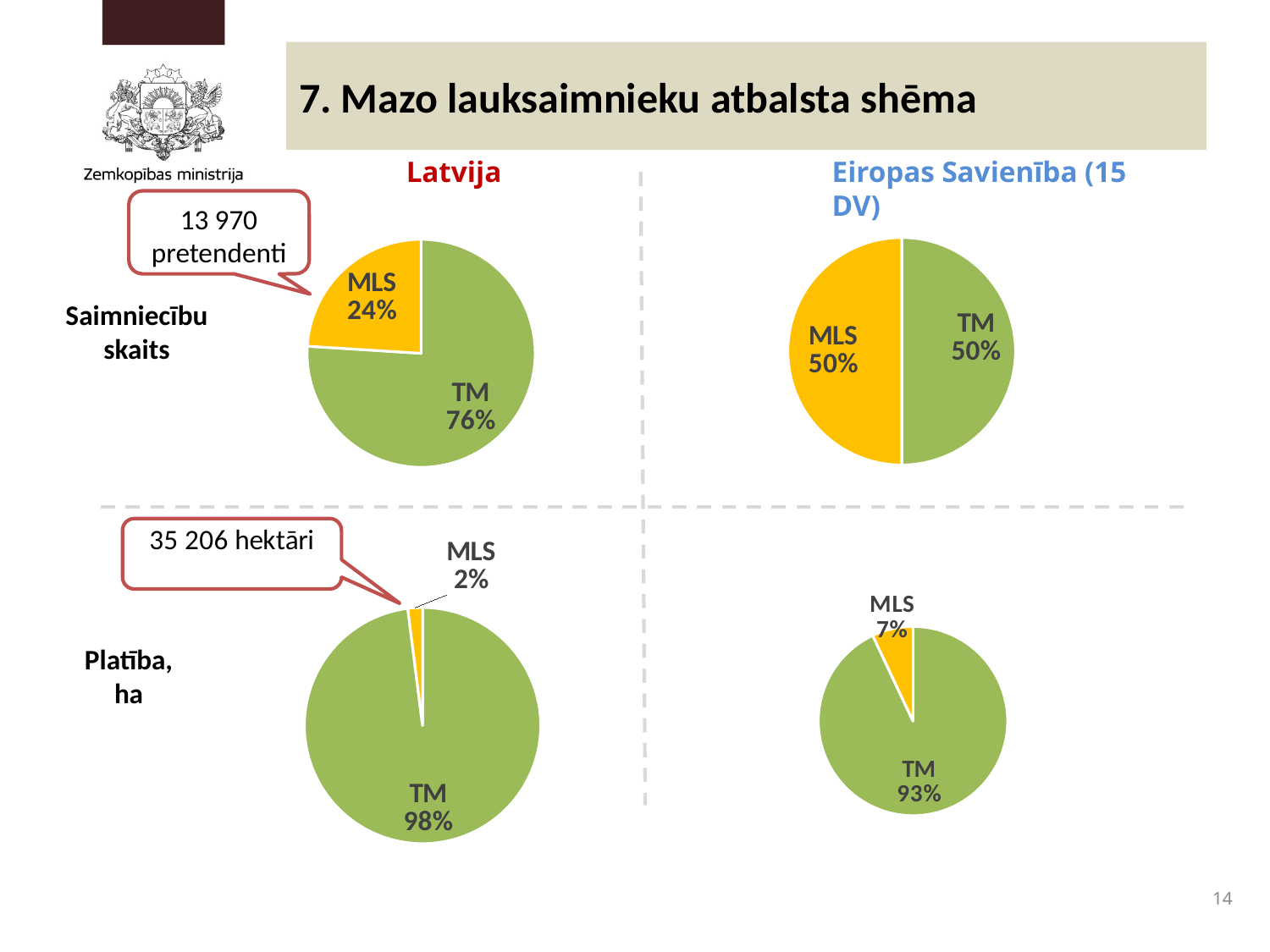
In the bottom-right pie chart (Eiropas Savienība, Platība), what share does MLS have? 7% In the top-left pie chart (Latvija, Saimniecību skaits), what is the difference between the TM and MLS shares? 52 percentage points In the bottom-left pie chart (Latvija, Platība), what share does TM have? 98% In the top-left pie chart (Latvija, Saimniecību skaits), what share does TM have? 76% How many slices does the top-right pie chart (Eiropas Savienība, Saimniecību skaits) have? 2 In the bottom-right pie chart (Eiropas Savienība, Platība), which slice is the smallest? MLS What kind of chart is used in the bottom-left (Latvija, Platība) position? Pie chart In the top-left pie chart (Latvija, Saimniecību skaits), which slice is the largest? TM